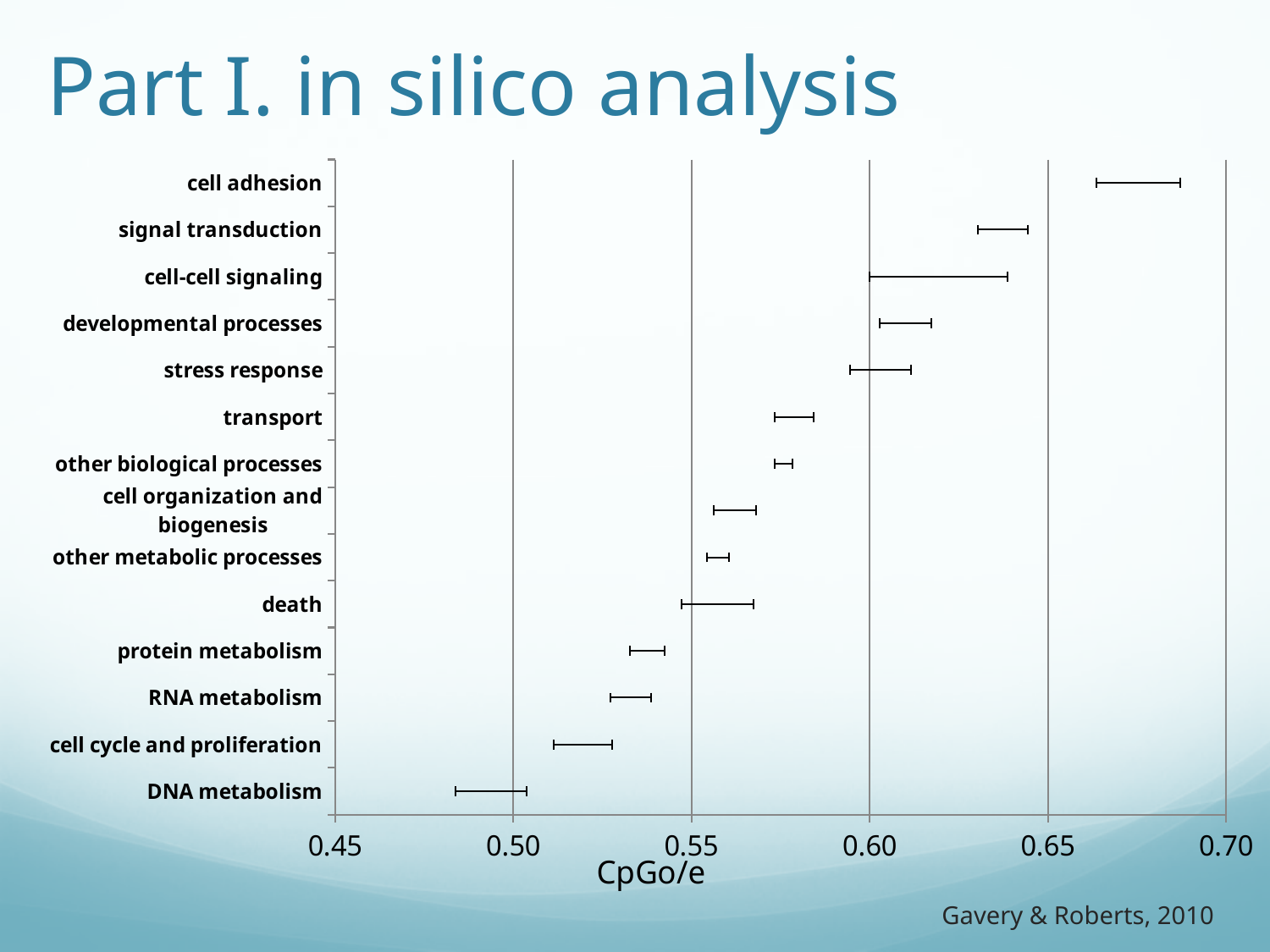
Which has a higher CpGo/e value, signal transduction or stress response? signal transduction How many categories are listed on the y axis of the chart? 14 Is the CpGo/e value for cell cycle and proliferation greater or less than 0.55? less Is the CpGo/e value for cell adhesion greater or less than 0.65? greater Which category has the highest CpGo/e value? cell adhesion Is the CpGo/e value for transport greater or less than 0.55? greater Do the CpGo/e values rise or fall going down the list of categories from cell adhesion to DNA metabolism? fall What is the label of the x axis of the chart? CpGo/e Which has a higher CpGo/e value, transport or RNA metabolism? transport Which category has the lowest CpGo/e value? DNA metabolism